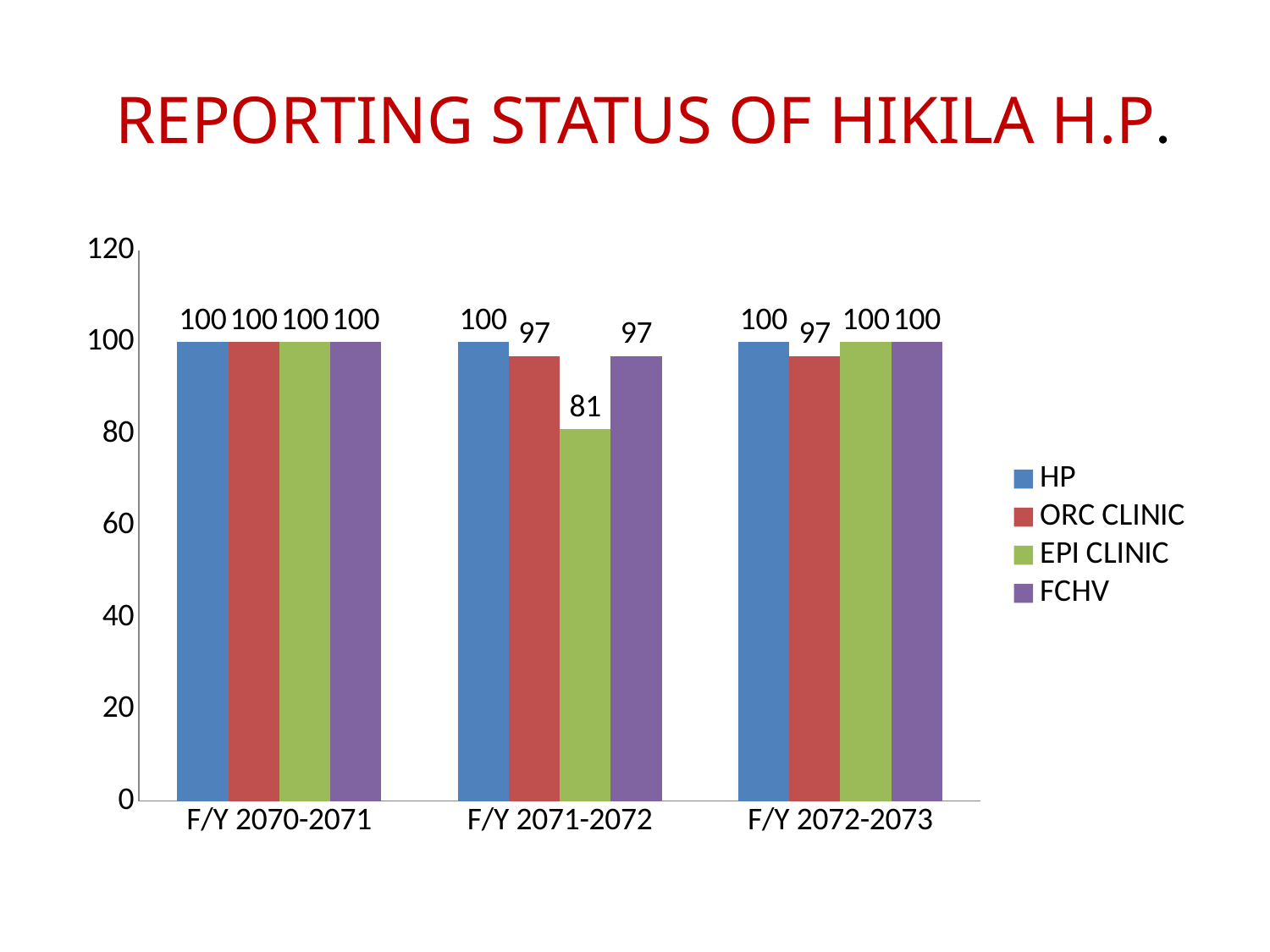
Which series has the lowest value in F/Y 2071-2072? EPI CLINIC How many series does the legend list? 4 What is the difference between the HP value and the EPI CLINIC value in F/Y 2071-2072? 19 What is the value for ORC CLINIC in F/Y 2072-2073? 97 What is the difference between the EPI CLINIC value in F/Y 2072-2073 and in F/Y 2071-2072? 19 How many fiscal year categories are shown on the x axis? 3 What kind of chart is shown on the slide? Bar chart What is the value for EPI CLINIC in F/Y 2071-2072? 81 Which is larger in F/Y 2071-2072, the ORC CLINIC value or the EPI CLINIC value? ORC CLINIC What is the value for FCHV in F/Y 2071-2072? 97 What is the value for HP in F/Y 2070-2071? 100 What is the title of the slide? REPORTING STATUS OF HIKILA H.P.